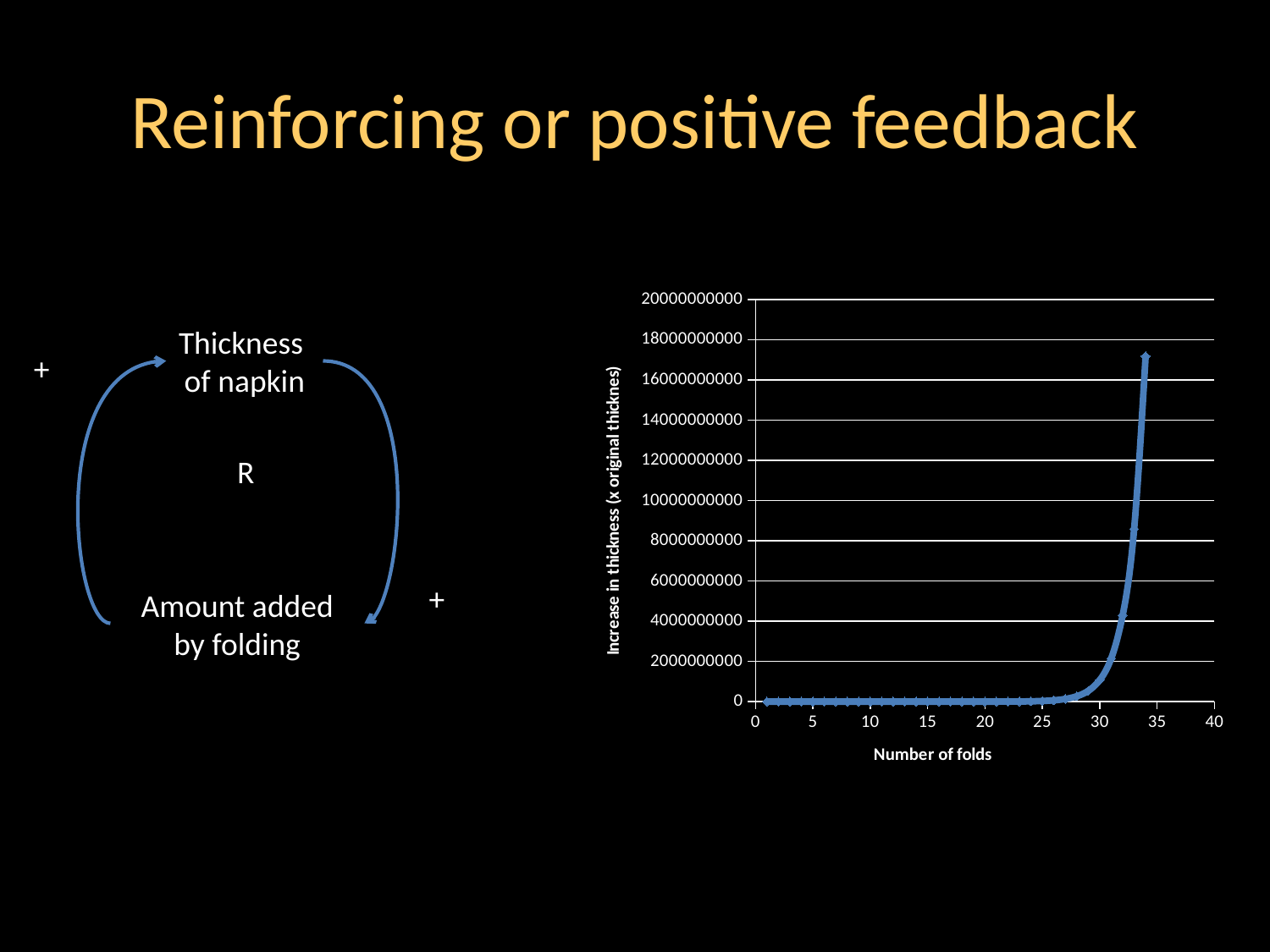
At which end of the x axis does the chart reach its highest value, the low end or the high end? high end What kind of chart is shown on the right of the slide? line chart Which has the larger value: 25 folds or 33 folds? 33 folds What is the highest value shown on the y axis of the chart? 20000000000 Which has the larger value: 30 folds or 34 folds? 34 folds Is the value at the highest number of folds plotted (around 34 folds) greater or less than 18000000000? less Is the value at the highest number of folds plotted (around 34 folds) greater or less than 16000000000? greater Is the value at 30 folds greater or less than 2000000000? less What is the title of the x axis of the chart? Number of folds Do the values in the chart rise or fall as the number of folds increases? rise What is the title of the y axis of the chart? Increase in thickness (x original thickness)